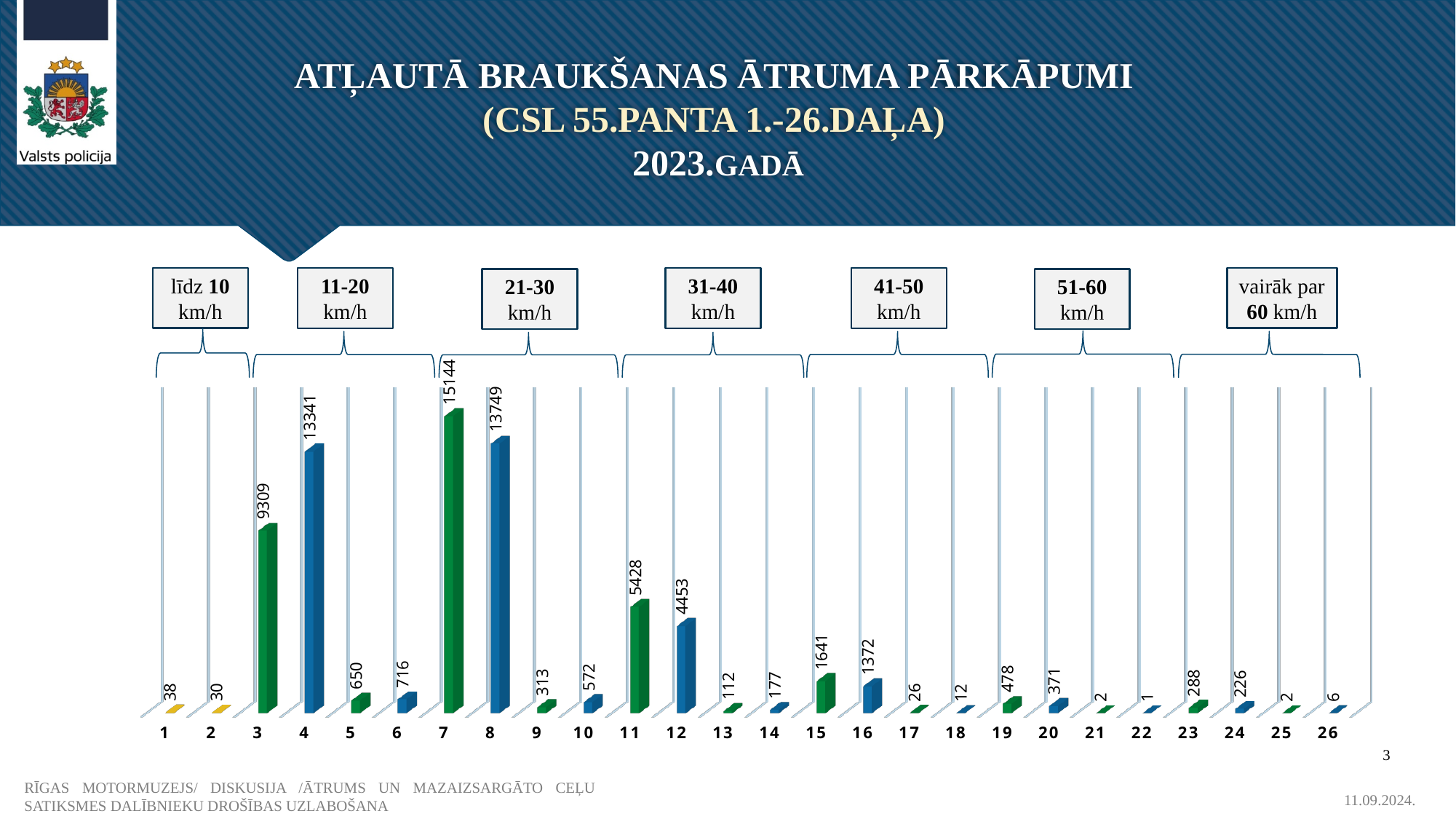
Which is larger, the value for category 11 or category 12? 11 What kind of chart is shown on the slide? bar chart What value is shown for category 11? 5428 What value is shown for category 7? 15144 What is the difference between the values for category 7 and category 8? 1395 What is the difference between the values for category 3 and category 4? 4032 Which category has the highest value? 7 What value is shown for category 19? 478 Which speed range label is shown above categories 7 to 10? 21-30 km/h How many categories are shown on the x axis? 26 Which category has the lowest value? 22 What value is shown for category 4? 13341